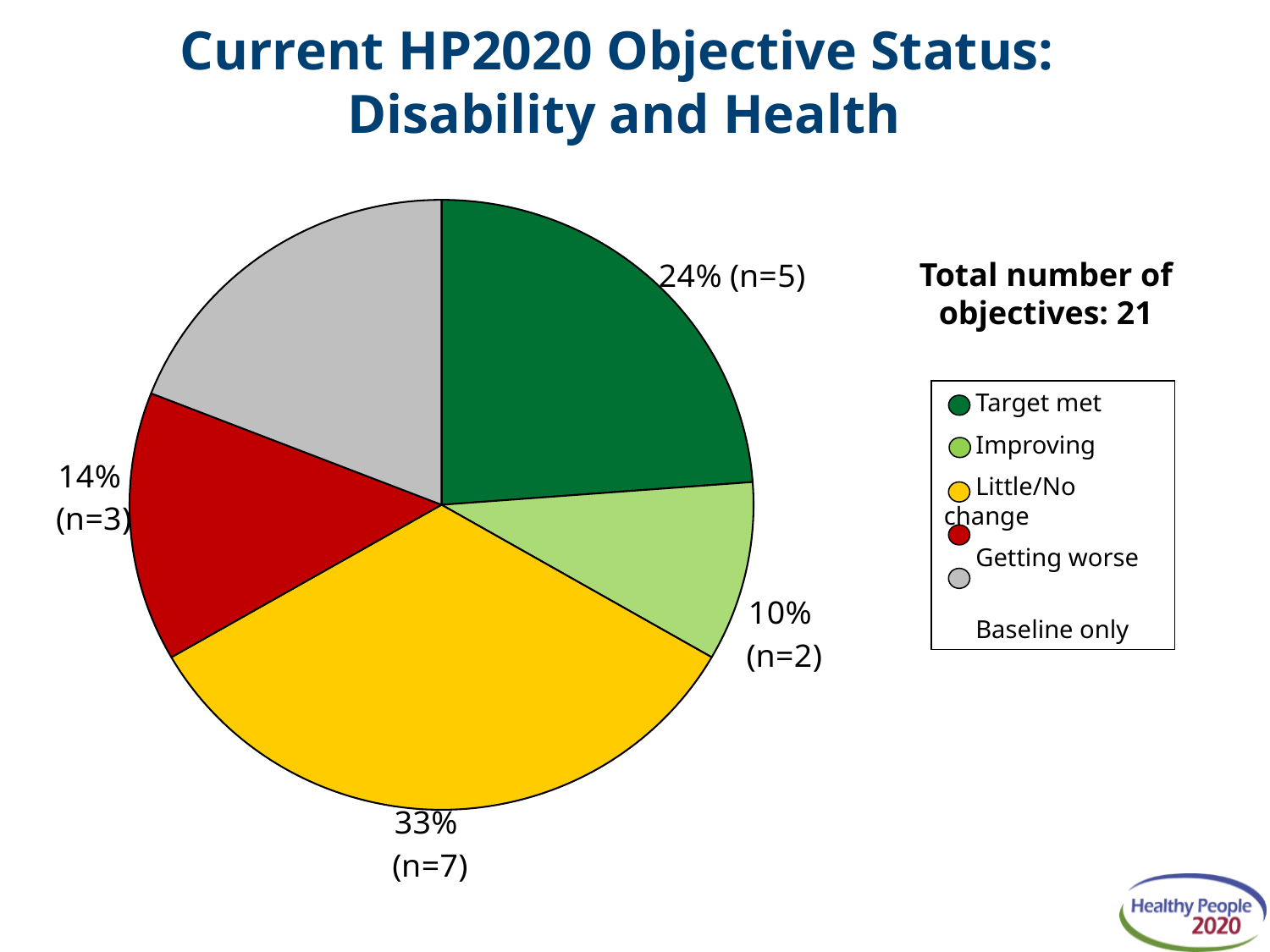
How many objectives are in the Little/No change category? 7 What is the total number of objectives stated on the slide? 21 What kind of chart is shown on the slide? pie chart Which is larger, the Target met slice or the Getting worse slice? Target met Which status category has the largest share of the pie? Little/No change What is the difference in percentage points between the Little/No change share and the Target met share? 9 What colour represents the Baseline only category in the pie chart? gray How many status categories does the legend list? 5 What percentage of objectives have the status Target met? 24% Which status category has the smallest share of the pie? Improving What percentage of objectives are Improving? 10% How many objectives are Getting worse? 3